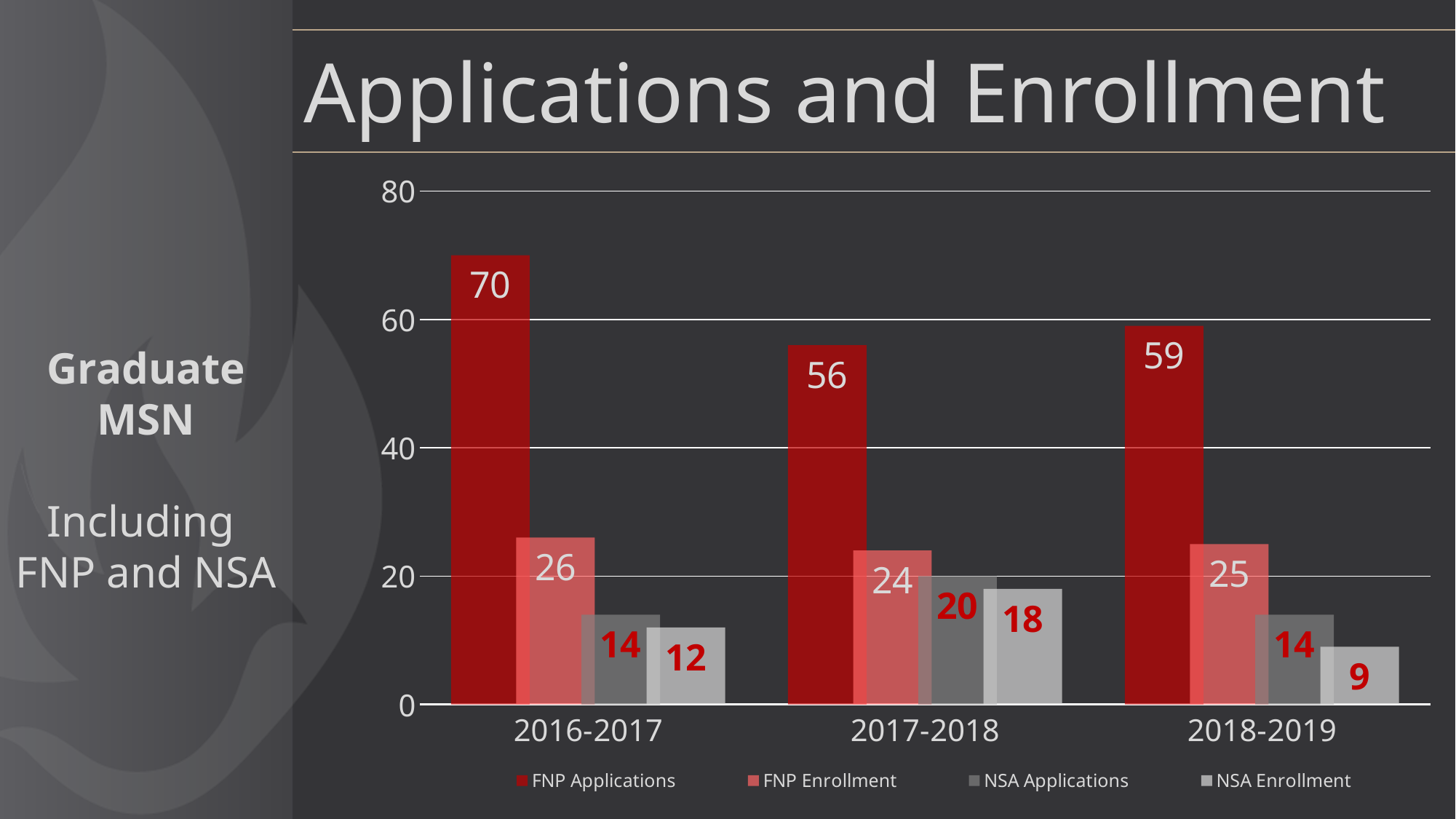
What is the value for NSA Applications in 2017-2018? 20 Which is larger in 2018-2019: FNP Enrollment or NSA Applications? FNP Enrollment In which year is NSA Enrollment lowest? 2018-2019 How many year categories are shown on the x axis? 3 What is the value for FNP Applications in 2016-2017? 70 What kind of chart is shown on the slide? Bar chart What is the difference between FNP Applications and FNP Enrollment in 2017-2018? 32 How many series does the legend list? 4 What is the value for NSA Enrollment in 2018-2019? 9 Do FNP Applications rise or fall from 2016-2017 to 2017-2018? Fall What is the title of the chart? Applications and Enrollment In which year are FNP Applications highest? 2016-2017